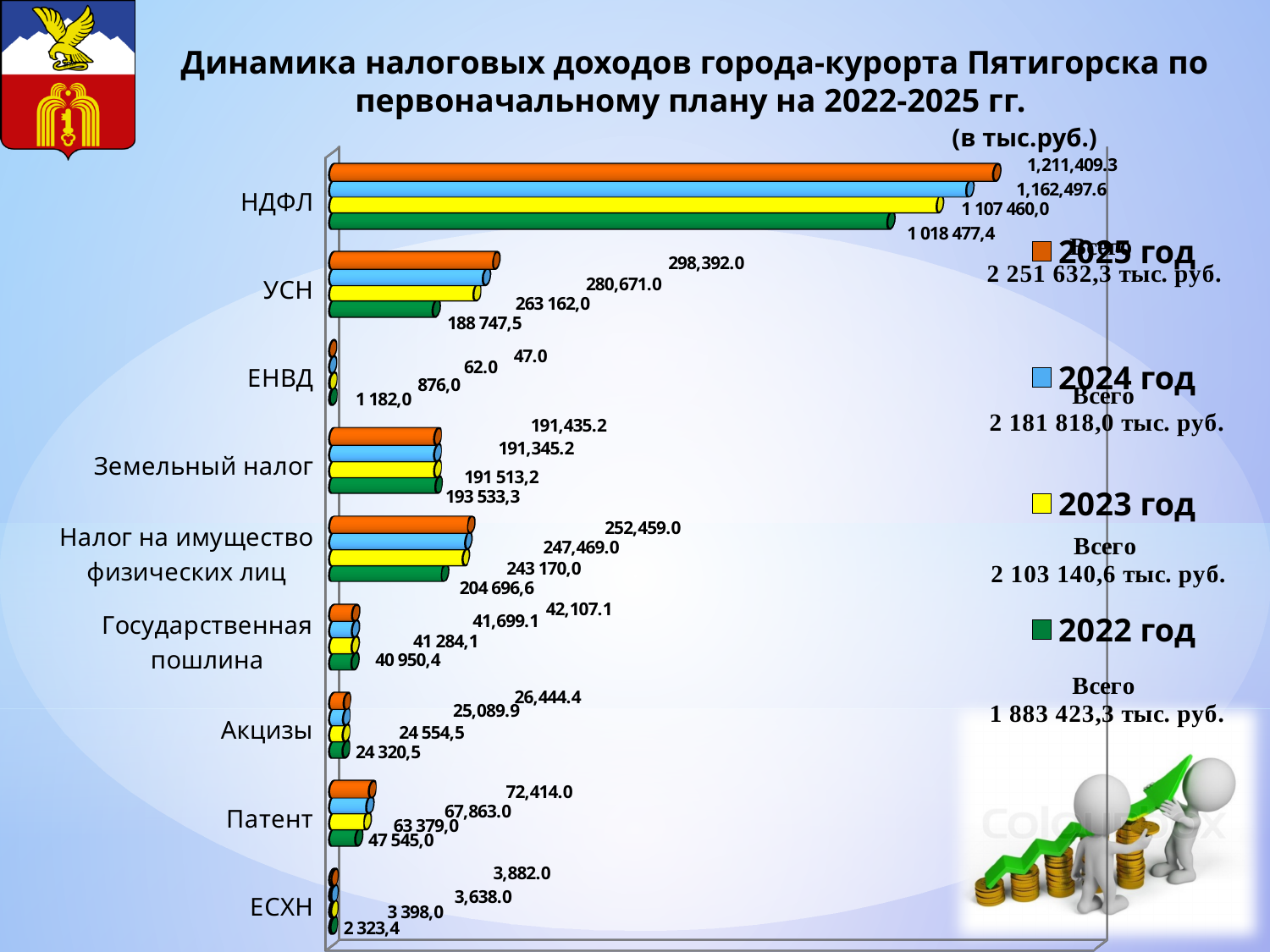
What is the difference between the 2025 год and 2024 год values for УСН? 17,721.0 How many tax categories are shown on the chart? 9 What is the value for Земельный налог in the 2022 год series? 193 533,3 How many series does the legend list? 4 What is the value for ЕСХН in the 2023 год series? 3 398,0 What kind of chart is shown on the slide? Bar chart What is the value for Патент in the 2022 год series? 47 545,0 Which category has the lowest value in the 2022 год series? ЕНВД What is the difference between the 2025 год and 2024 год values for Патент? 4,551.0 What is the value for НДФЛ in the 2025 год series? 1,211,409.3 In the 2025 год series, which is larger: Акцизы or Патент? Патент Which category has the highest value in the 2025 год series? НДФЛ